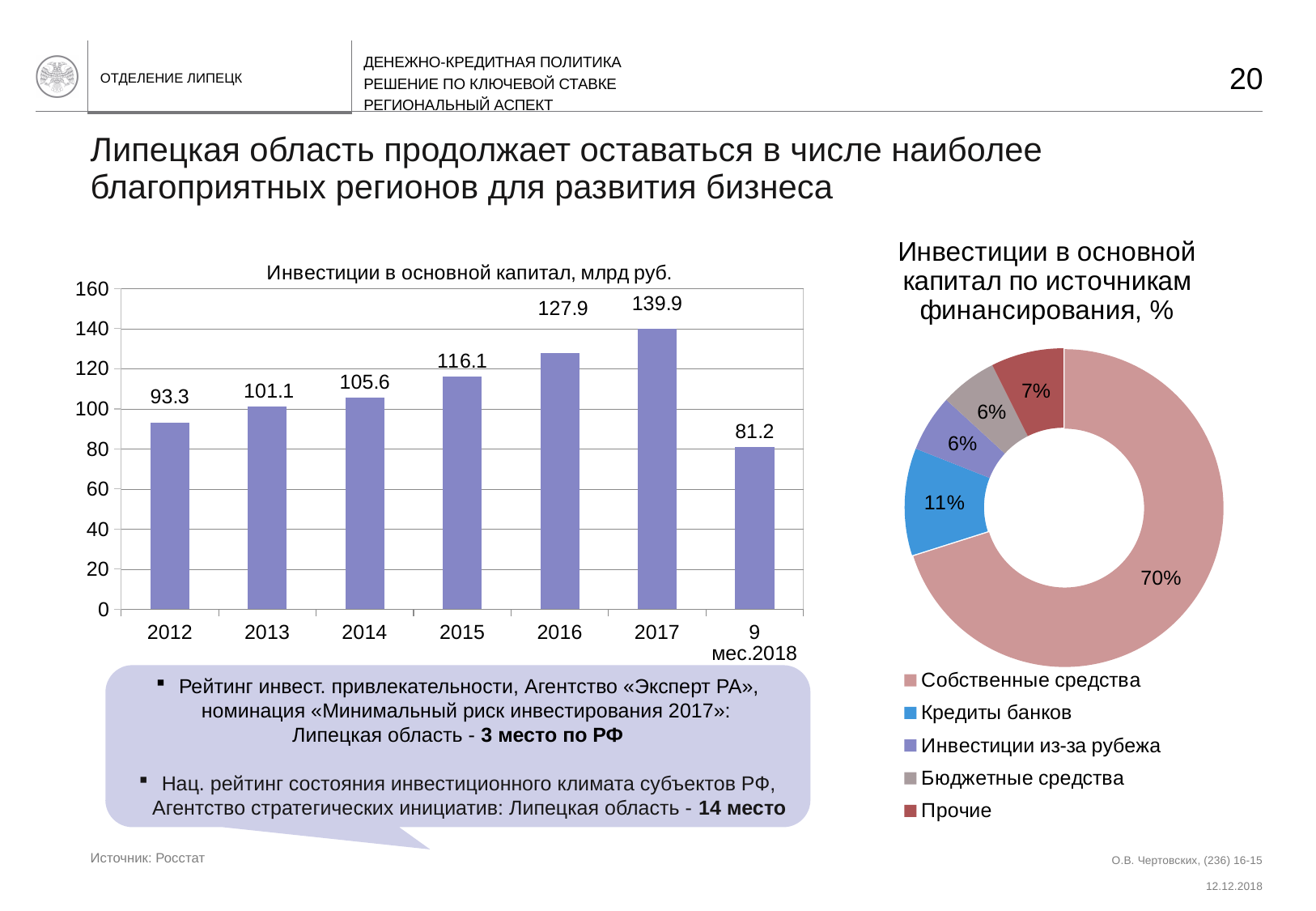
In the bar chart 'Инвестиции в основной капитал, млрд руб.', what is the value for 9 мес.2018? 81.2 In the bar chart 'Инвестиции в основной капитал, млрд руб.', what is the difference between the 2017 and 2012 values? 46.6 In the bar chart 'Инвестиции в основной капитал, млрд руб.', which is larger: the value for 2014 or for 2016? 2016 In the bar chart 'Инвестиции в основной капитал, млрд руб.', which category has the lowest value? 9 мес.2018 In the bar chart 'Инвестиции в основной капитал, млрд руб.', which year has the highest value? 2017 In the bar chart 'Инвестиции в основной капитал, млрд руб.', what is the value for 2015? 116.1 How many entries does the legend of the pie chart 'Инвестиции в основной капитал по источникам финансирования, %' list? 5 In the pie chart 'Инвестиции в основной капитал по источникам финансирования, %', which source has the largest share? Собственные средства In the pie chart 'Инвестиции в основной капитал по источникам финансирования, %', what share is Кредиты банков? 11% In the bar chart 'Инвестиции в основной капитал, млрд руб.', do the values rise or fall from 2012 to 2017? rise In the bar chart 'Инвестиции в основной капитал, млрд руб.', how many bars are plotted? 7 What type of chart is the one on the left of the slide? bar chart